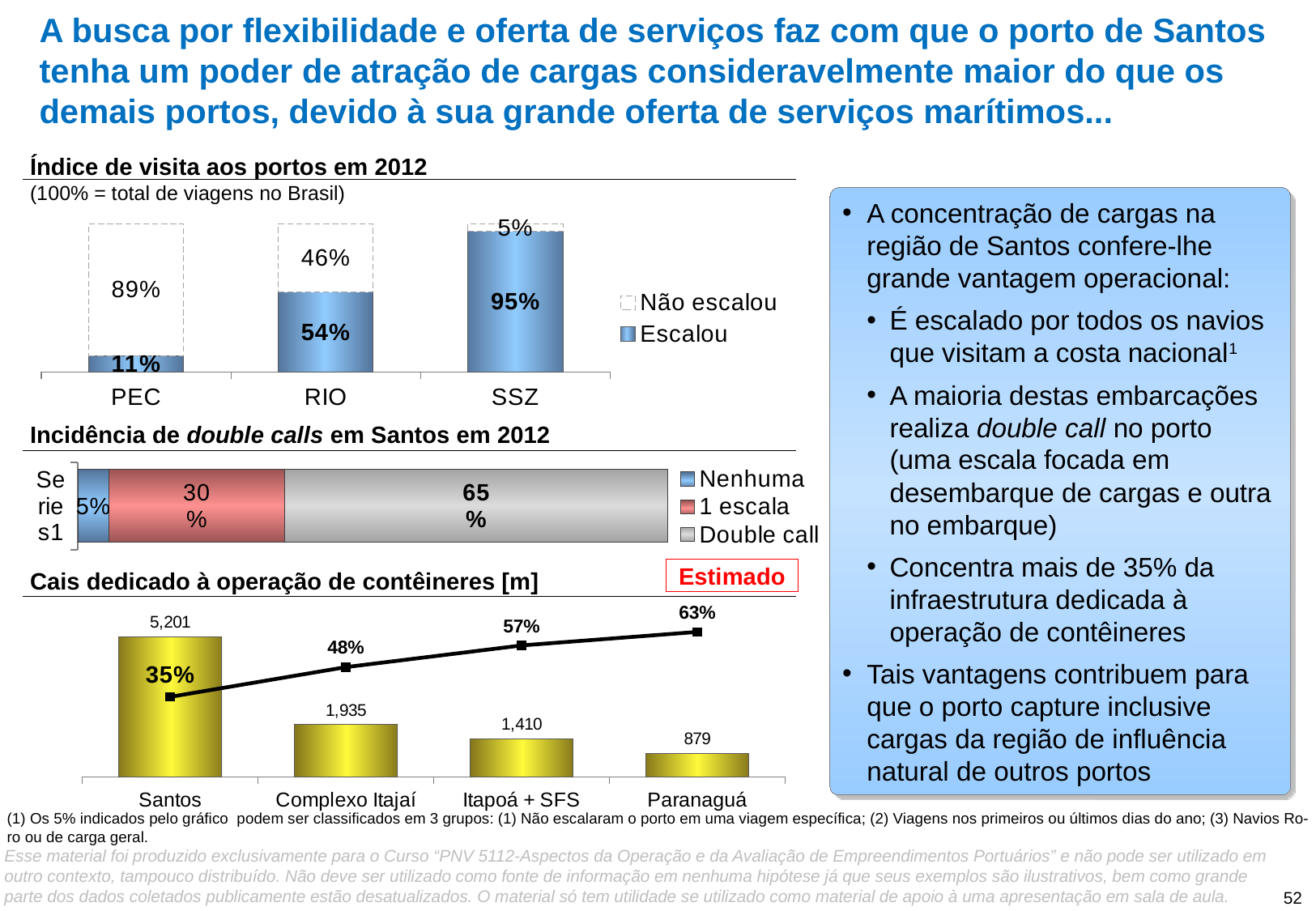
In the chart 'Incidência de double calls em Santos em 2012', what is the value for 'Double call'? 65% In the chart 'Cais dedicado à operação de contêineres [m]', how many ports are shown on the x axis? 4 In the chart 'Incidência de double calls em Santos em 2012', which category has the lowest value? Nenhuma In the chart 'Índice de visita aos portos em 2012', how many series does the legend list? 2 In the chart 'Índice de visita aos portos em 2012', what is the 'Não escalou' value for PEC? 89% In the chart 'Cais dedicado à operação de contêineres [m]', what is the difference between the values for Santos and Itapoá + SFS? 3,791 In the chart 'Cais dedicado à operação de contêineres [m]', which port has the lowest value? Paranaguá In the chart 'Incidência de double calls em Santos em 2012', what is the total of the stacked bar? 100% In the chart 'Índice de visita aos portos em 2012', what is the difference between the 'Escalou' values for SSZ and PEC? 84% In the chart 'Cais dedicado à operação de contêineres [m]', what is the value for Complexo Itajaí? 1,935 In the chart 'Índice de visita aos portos em 2012', what is the 'Escalou' value for RIO? 54% In the chart 'Índice de visita aos portos em 2012', which port has the highest 'Escalou' value? SSZ